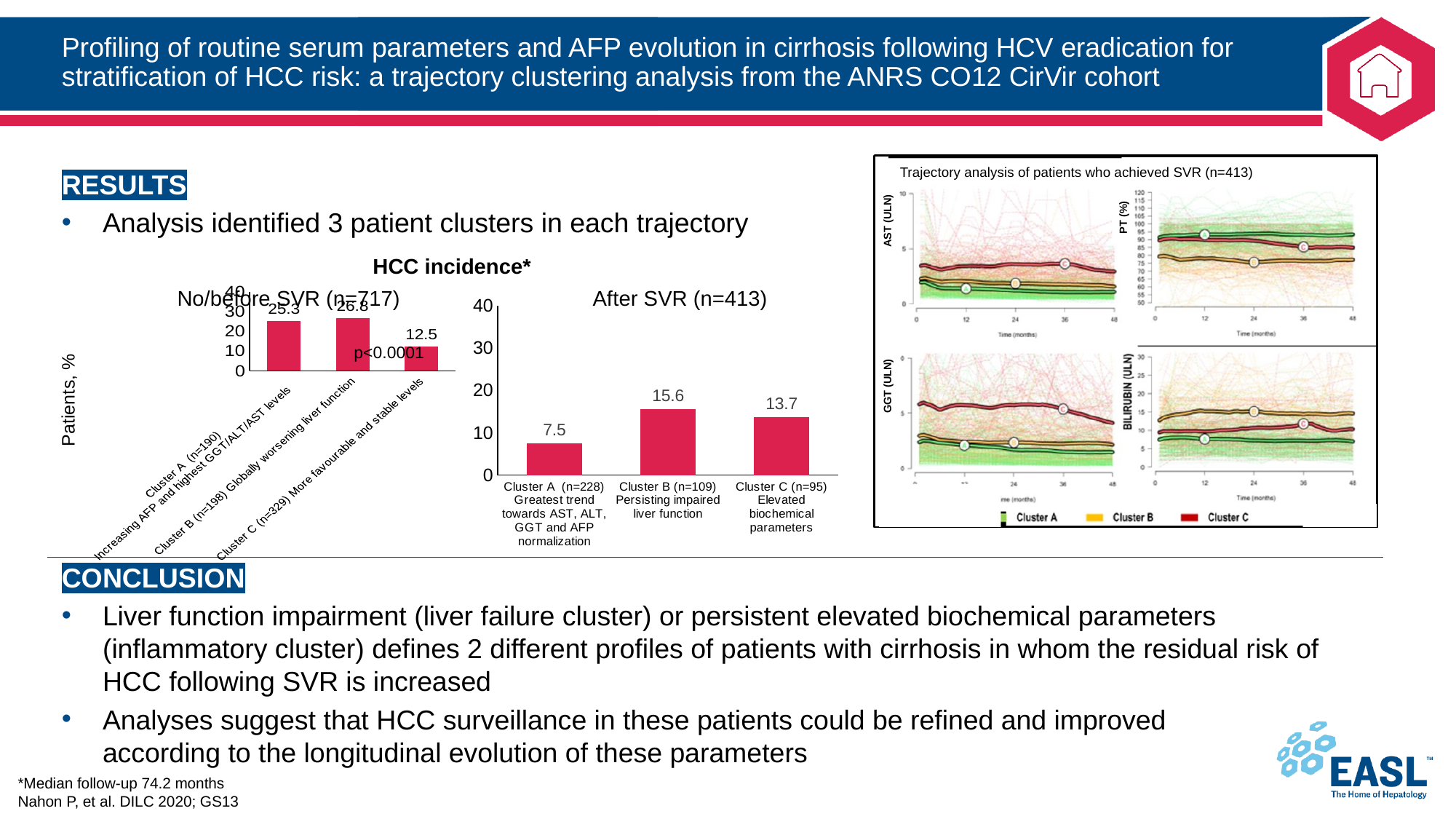
In the 'After SVR (n=413)' chart, how much higher is the value for Cluster B than for Cluster A? 8.1 What p-value is printed on the 'No/before SVR (n=717)' chart? p<0.0001 In the 'No/before SVR (n=717)' chart, what is the difference between the values for Cluster B and Cluster C? 14.3 In the 'After SVR (n=413)' chart, what is the value for Cluster B (n=109)? 15.6 In the 'After SVR (n=413)' chart, which cluster has the lowest HCC incidence? Cluster A (n=228) What type of chart is used to show HCC incidence for the 'After SVR (n=413)' group? Bar chart In the 'After SVR (n=413)' chart, which cluster has the highest HCC incidence? Cluster B (n=109) How many bars are plotted in the 'After SVR (n=413)' chart? 3 Which is larger: the Cluster A value in the 'No/before SVR (n=717)' chart or the Cluster A value in the 'After SVR (n=413)' chart? No/before SVR (n=717) In the 'After SVR (n=413)' chart, what is the HCC incidence value for Cluster A (n=228)? 7.5 In the 'No/before SVR (n=717)' chart, what is the value for Cluster C (n=329)? 12.5 In the 'No/before SVR (n=717)' chart, which cluster has the highest HCC incidence? Cluster B (n=198)